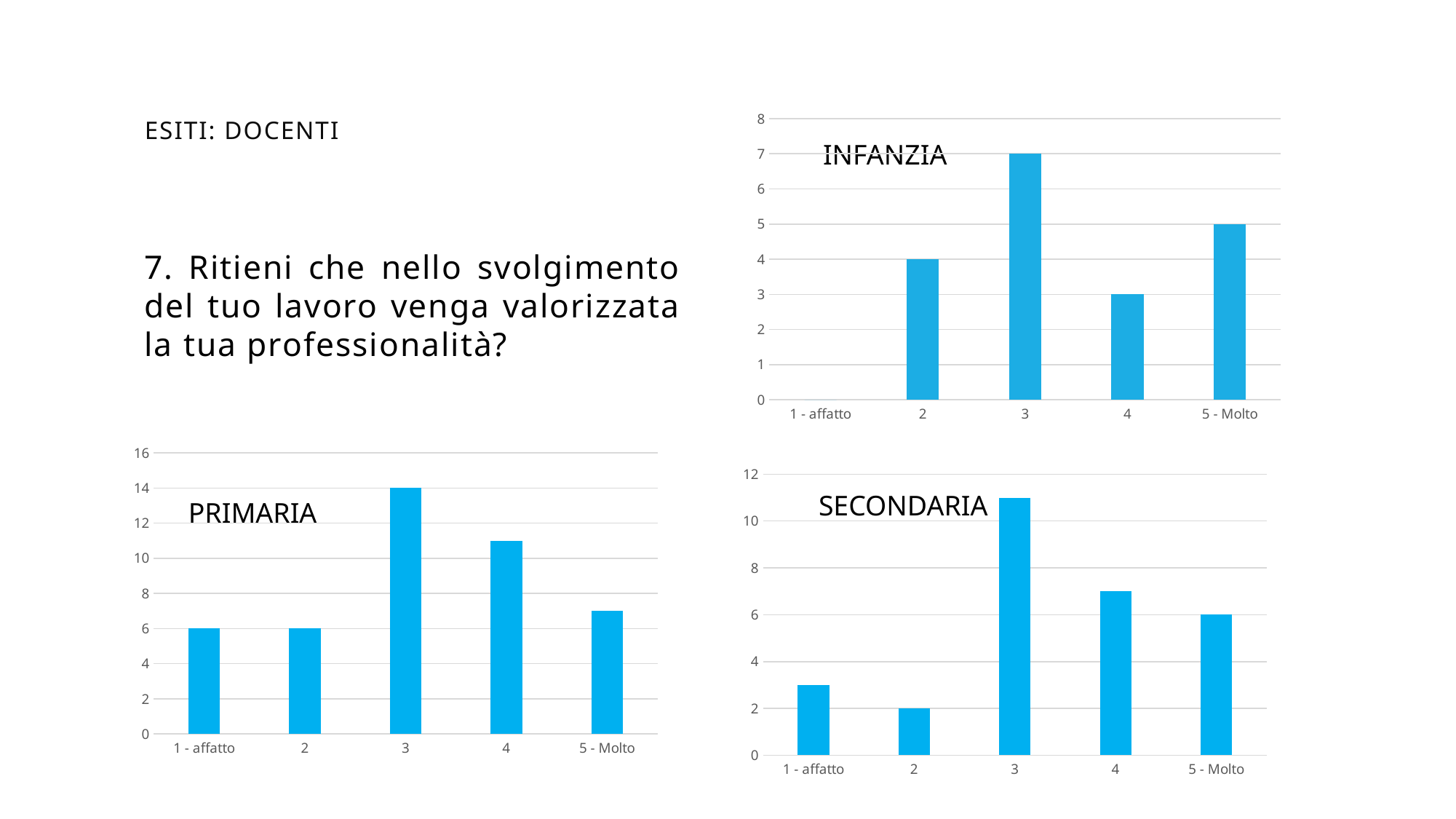
In the SECONDARIA chart, what is the value for 5 - Molto? 6 In the INFANZIA chart, what is the value for category 3? 7 In the INFANZIA chart, what is the value for 5 - Molto? 5 In the INFANZIA chart, what is the difference between the values for category 3 and category 4? 4 In the PRIMARIA chart, which is larger, the value for category 4 or for 5 - Molto? 4 In the INFANZIA chart, what is the value for category 2? 4 In the SECONDARIA chart, which category has the lowest value? 2 In the PRIMARIA chart, what is the value for category 3? 14 In the PRIMARIA chart, which category has the highest value? 3 In the SECONDARIA chart, is the value for category 3 greater or less than 10? greater What kind of chart is the SECONDARIA chart? bar chart How many categories are shown on the x axis of the PRIMARIA chart? 5